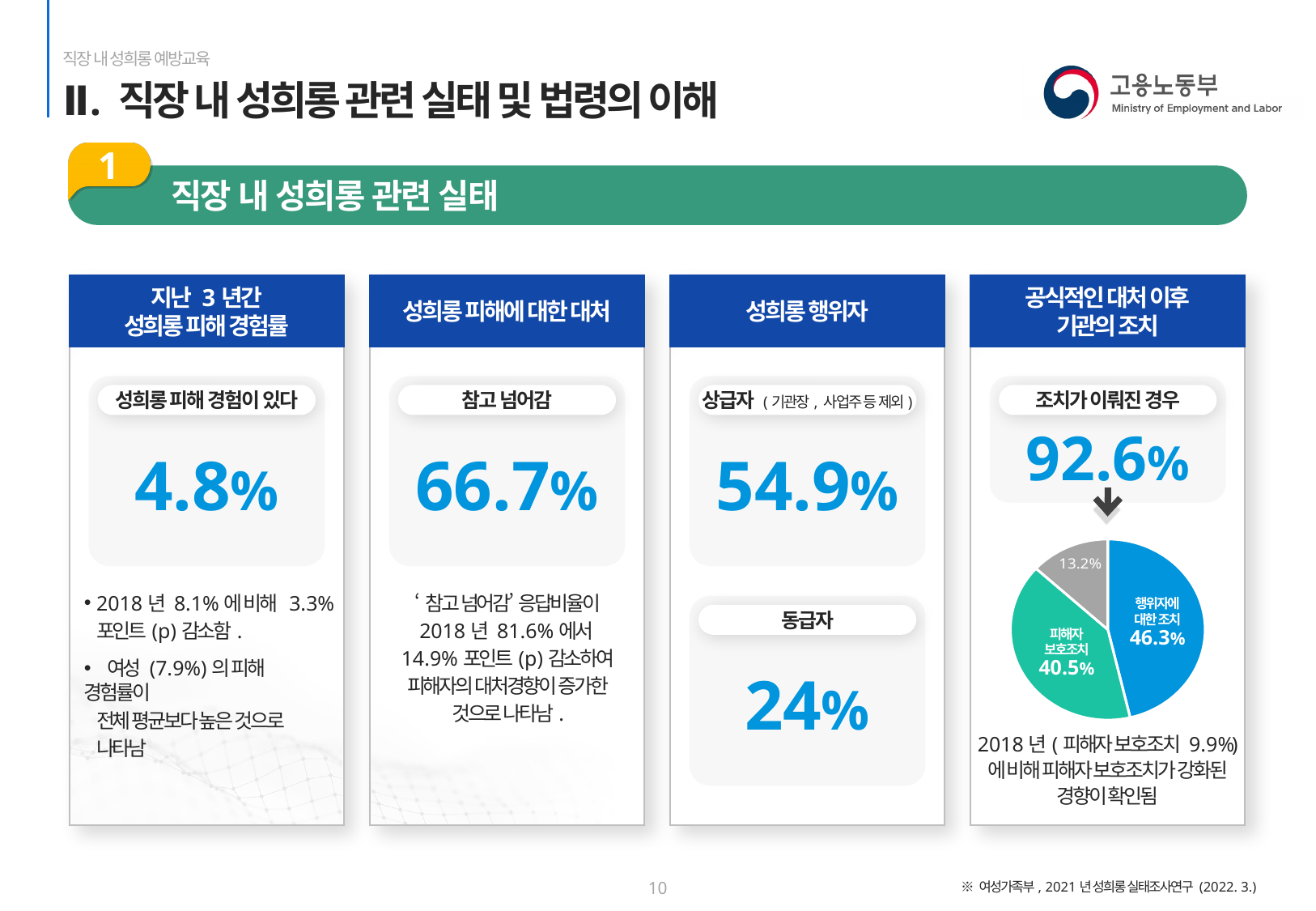
What kind of chart is shown in the '공식적인 대처 이후 기관의 조치' panel? pie chart Which slice of the pie chart is the largest? 행위자에 대한 조치 In the pie chart, what share is labelled for '행위자에 대한 조치'? 46.3% How many slices does the pie chart have? 3 What is the value of the smallest slice in the pie chart? 13.2% In the pie chart, which is larger: '행위자에 대한 조치' or '피해자 보호조치'? 행위자에 대한 조치 In the pie chart, what is the value of the gray slice? 13.2% In the pie chart, what share of the whole does '피해자 보호조치' represent? 40.5% In the pie chart, what share is labelled for '피해자 보호조치'? 40.5% What colour is the '행위자에 대한 조치' slice in the pie chart? blue In the pie chart, what is the difference between '행위자에 대한 조치' and '피해자 보호조치'? 5.8 percentage points What colour is the '피해자 보호조치' slice in the pie chart? green